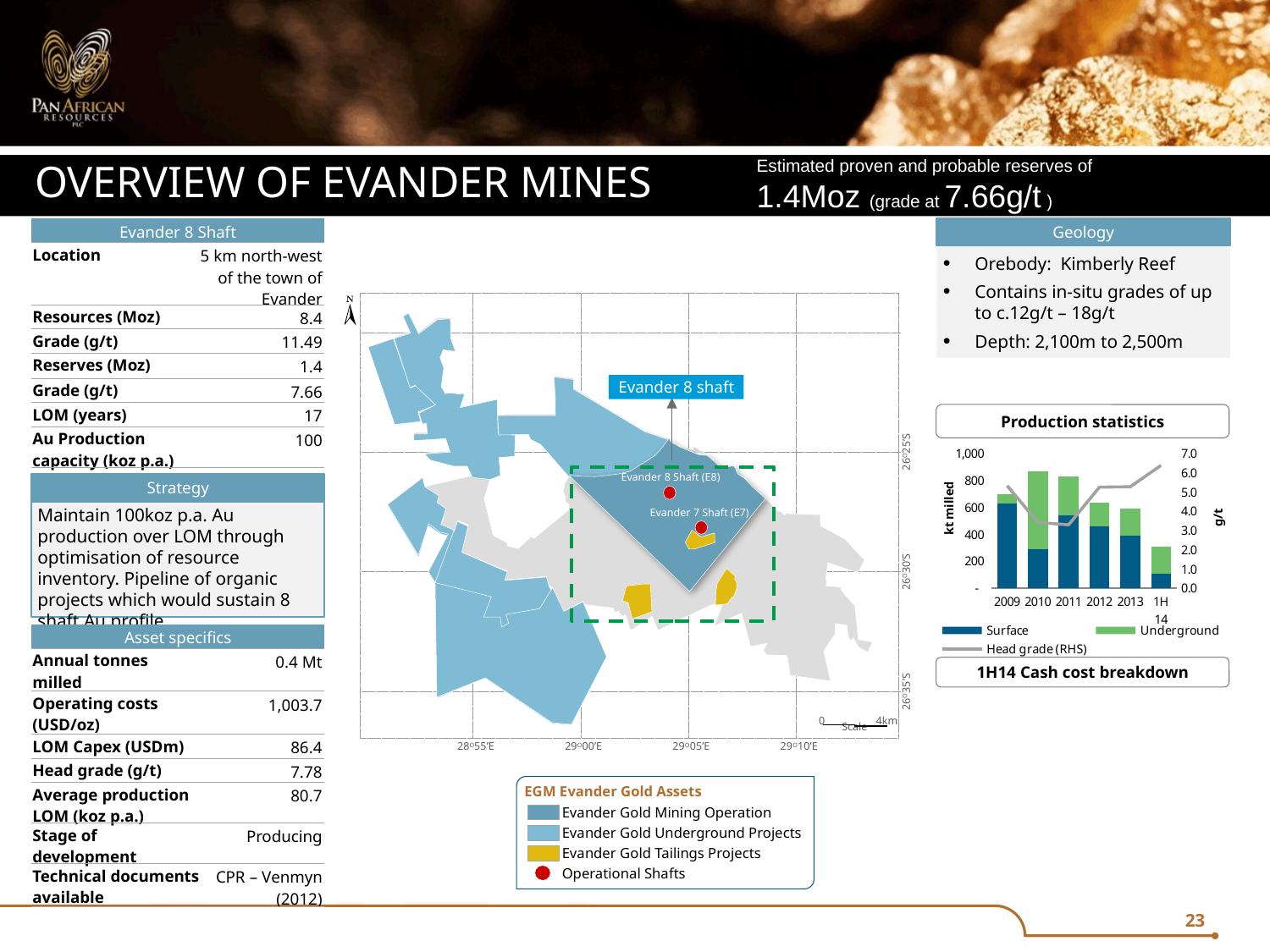
In the Production statistics chart, is the Surface value for 2010 greater or less than 400? less Which series in the Production statistics chart is plotted on the right-hand axis? Head grade (RHS) How many periods are shown on the x axis of the Production statistics chart? 6 In the Production statistics chart, is the Surface value for 2009 larger or smaller than the Surface value for 2010? larger In the Production statistics chart, which period has the lowest total kt milled? 1H 14 In the Production statistics chart, is the Head grade (RHS) value for 1H 14 greater or less than 5.0? greater In the Production statistics chart, is the total kt milled for 2009 greater or less than 600? greater In the Production statistics chart, which period has the highest Surface value? 2009 What is the label of the left vertical axis of the Production statistics chart? kt milled How many series does the legend of the Production statistics chart list? 3 What kind of chart is the Production statistics chart? combination bar and line chart